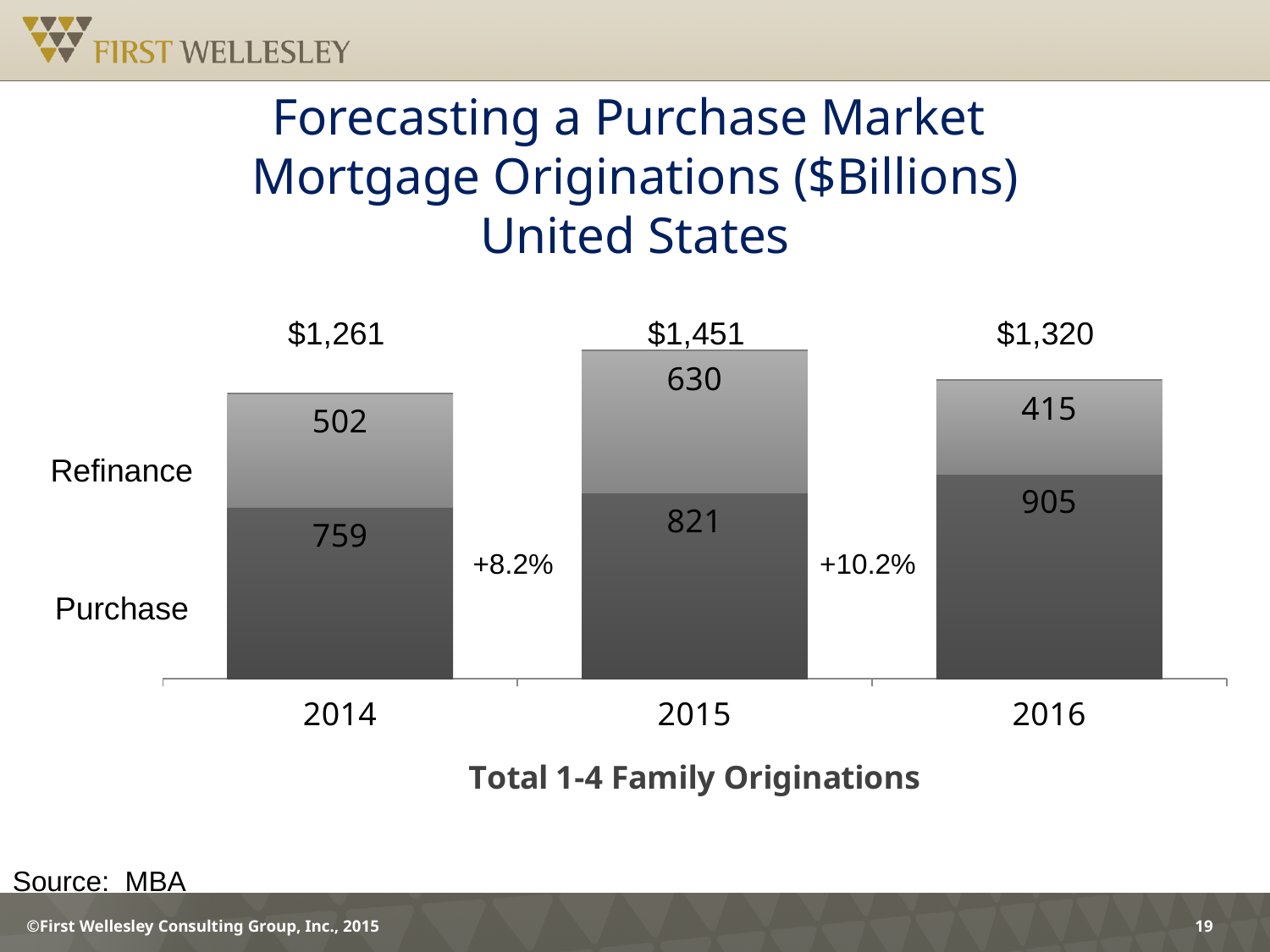
How many years are shown on the x axis? 3 What kind of chart is this? Stacked bar chart Which year has the lowest Refinance value? 2016 Which is larger, the Refinance value for 2014 or the Refinance value for 2016? 2014 What is the total of the stacked bar for 2016? $1,320 What is the Purchase value for 2014? 759 What is the Refinance value for 2015? 630 What is the difference between the Purchase values for 2016 and 2015? 84 Which year has the highest Purchase value? 2016 What is the total of the stacked bar for 2015? $1,451 What is the Refinance value for 2016? 415 Do the Purchase values rise or fall from 2014 to 2016? Rise